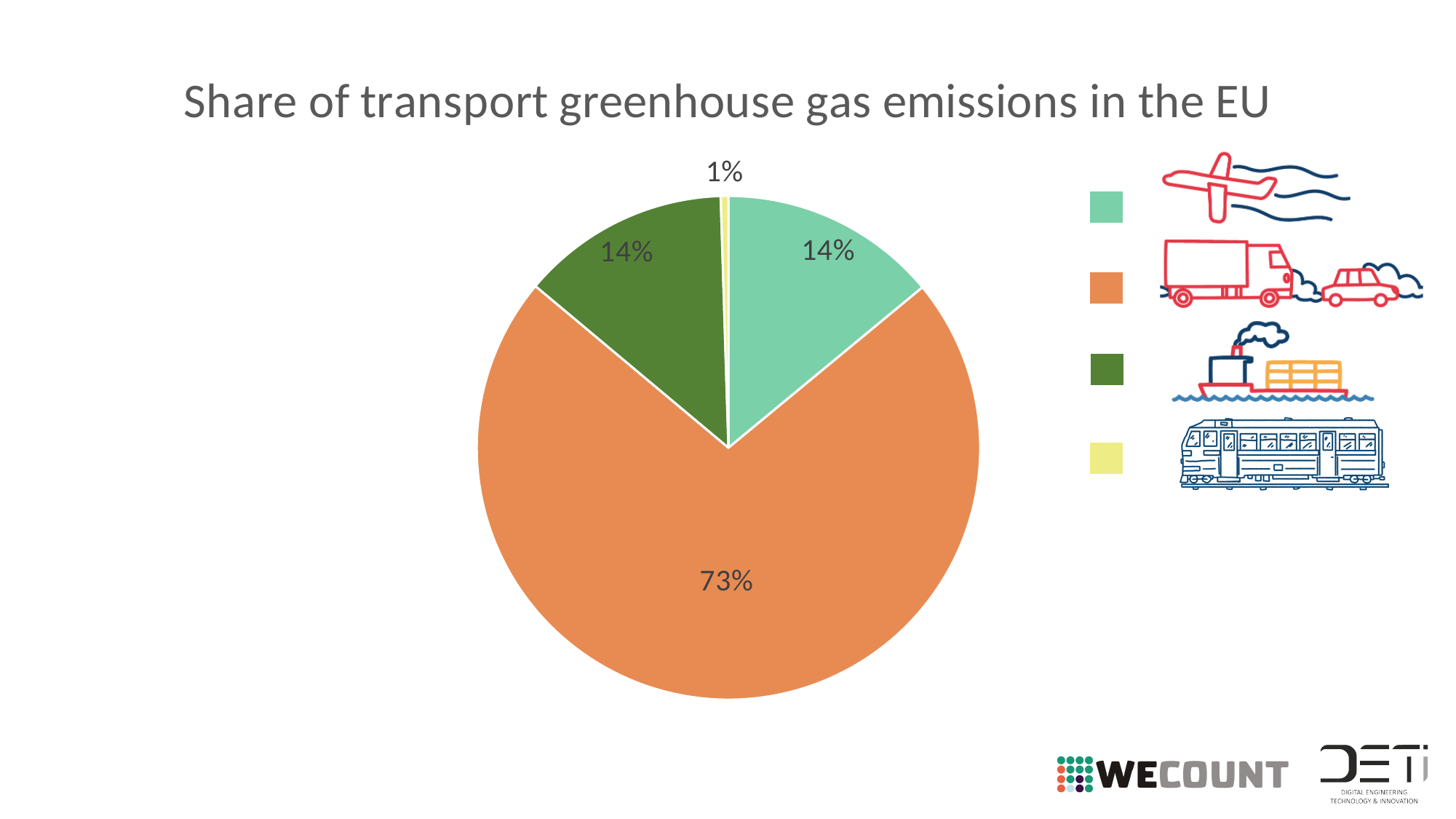
What share of the pie does the orange slice (truck and car icon in the legend) represent? 73% What value is shown for the yellow slice (train icon in the legend)? 1% Which slice of the pie is the smallest? the yellow slice (train icon) What value is shown for the light green slice (aeroplane icon in the legend)? 14% How many slices does the pie chart have? 4 What kind of chart is shown on the slide? pie chart How many entries does the legend list? 4 Which is larger, the orange slice or the light green slice? the orange slice What is the difference in percentage points between the orange slice and the dark green slice? 59 percentage points What is the title of the chart? Share of transport greenhouse gas emissions in the EU Which slice of the pie is the largest? the orange slice (truck and car icon) What value is shown for the dark green slice (ship icon in the legend)? 14%